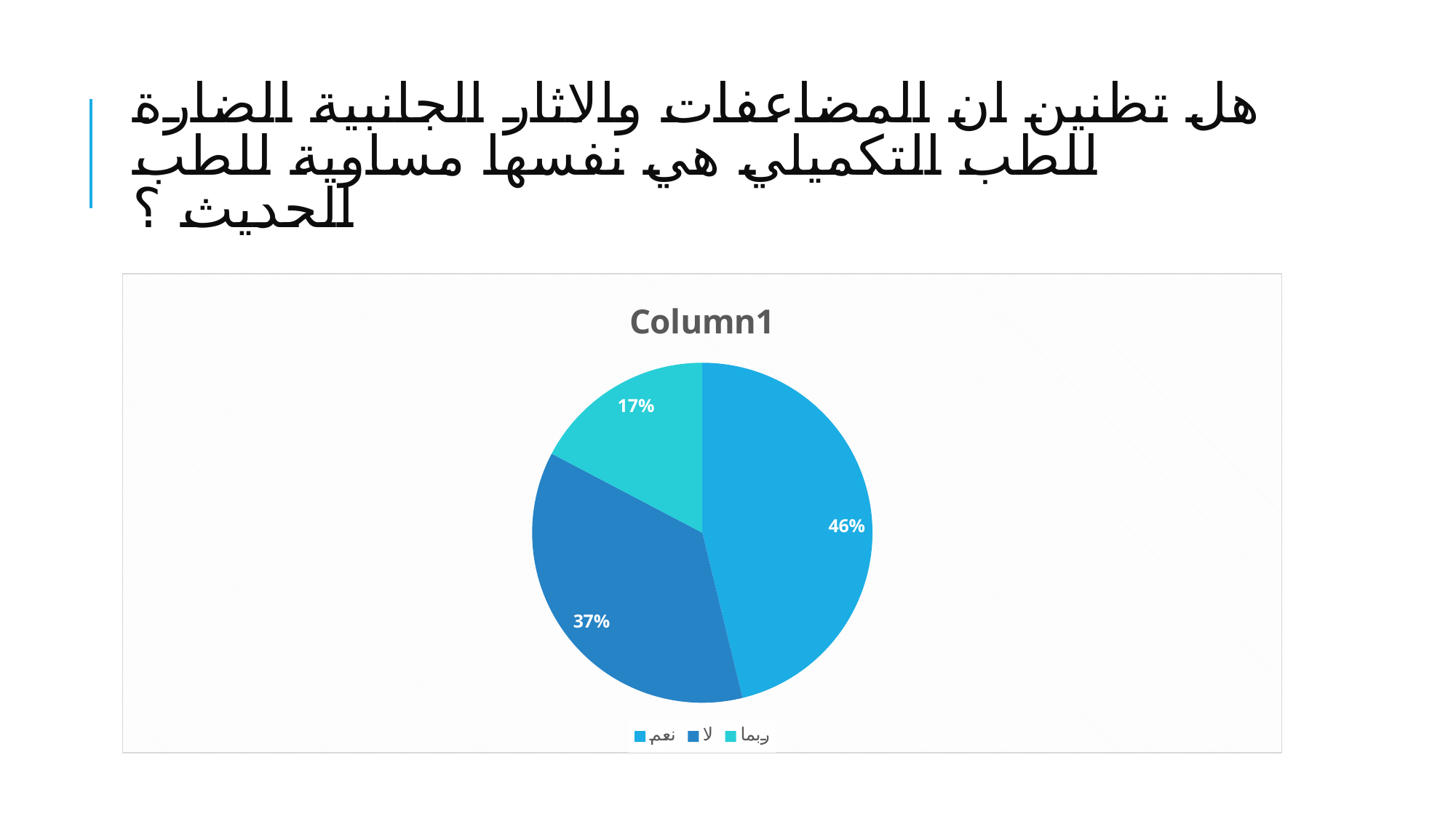
What percentage of the pie is the ربما slice? 17% What is the difference in percentage points between the نعم slice and the لا slice? 9 What is the difference in percentage points between the لا slice and the ربما slice? 20 What percentage of the pie is the لا slice? 37% Which category has the largest share of the pie? نعم How many slices does the pie chart have? 3 Which is larger, the share for لا or the share for ربما? لا How many entries does the legend list? 3 Which category has the smallest share of the pie? ربما What is the title of the chart? Column1 What kind of chart is shown on the slide? pie chart What percentage of the pie is the نعم slice? 46%